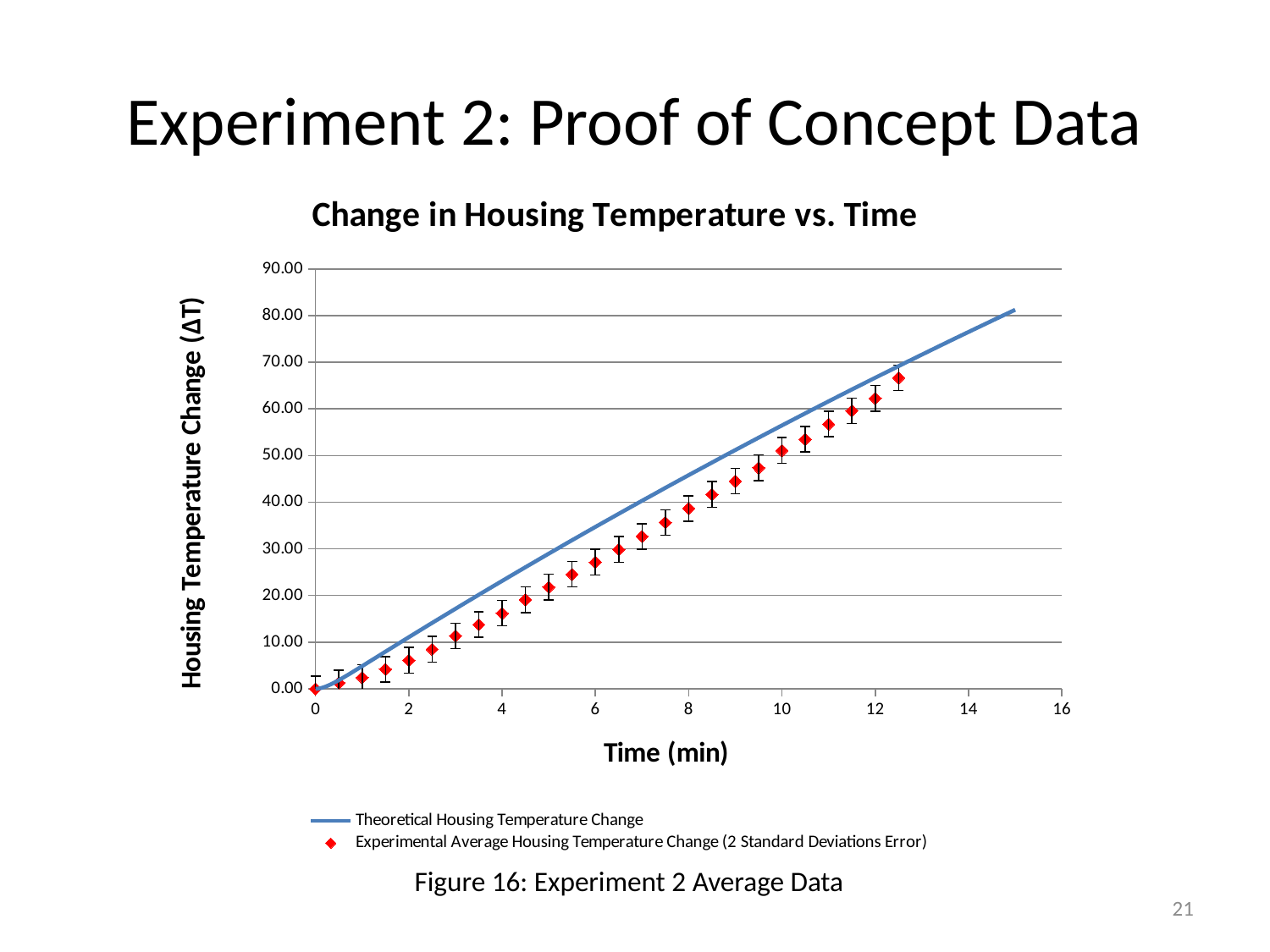
Is the experimental average housing temperature change at 12.5 minutes greater or less than 70.00? less At 10 minutes, which series has the larger value: the theoretical housing temperature change or the experimental average? Theoretical Housing Temperature Change How many series does the chart legend list? 2 How many experimental data points are plotted on the chart? 26 Is the experimental average housing temperature change at 6 minutes greater or less than 30.00? less Is the theoretical housing temperature change at 10 minutes greater or less than 50.00? greater What is the label of the x axis? Time (min) What is the title of the chart? Change in Housing Temperature vs. Time What kind of chart is shown on the slide? Line chart with scatter points Do the experimental housing temperature change values rise or fall as time increases? Rise At what time does the experimental average housing temperature change reach its highest plotted value? 12.5 min